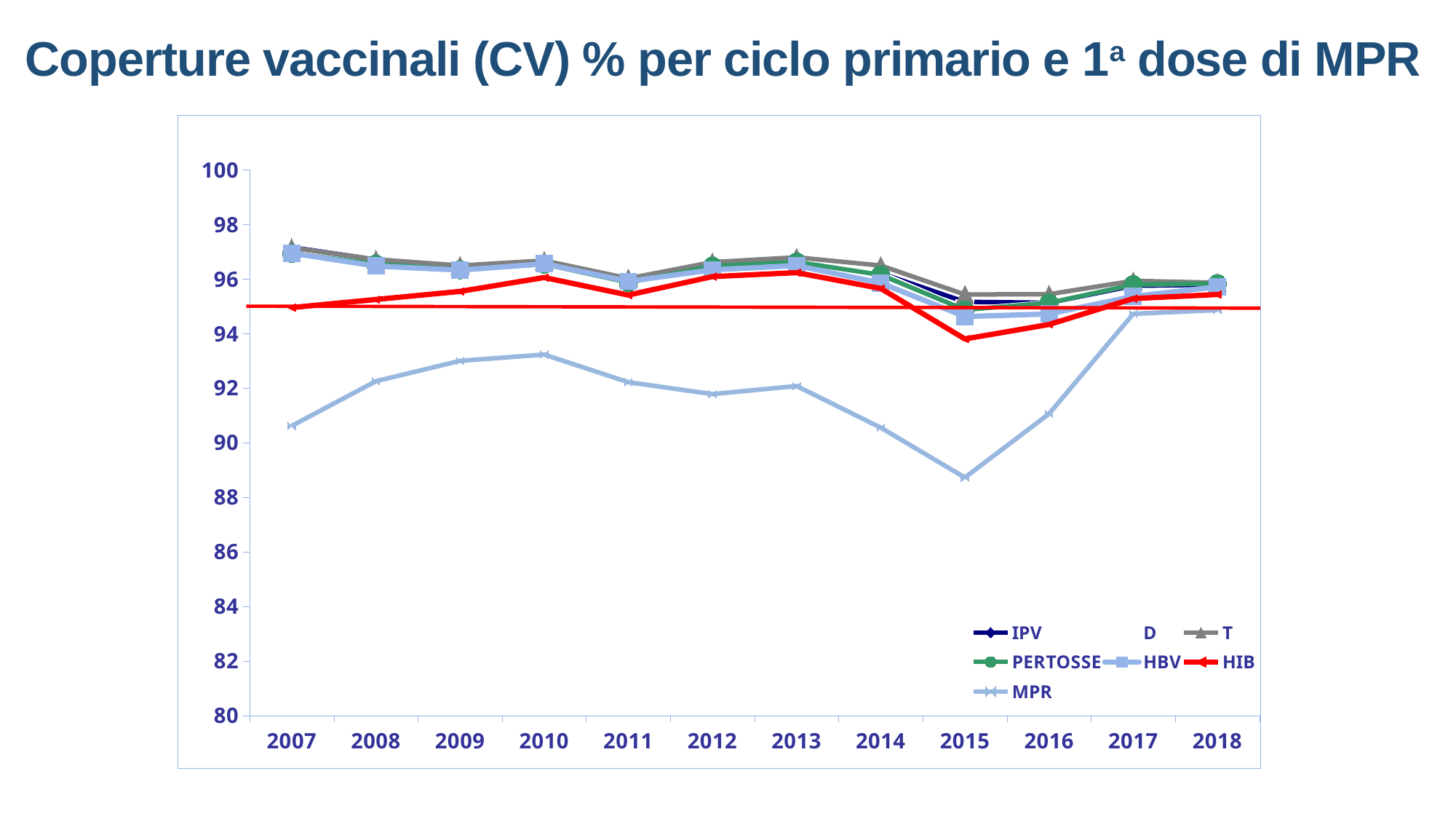
Which series lies lowest on the chart across all years? MPR In which year does the HIB series reach its lowest value? 2015 How many years are shown on the x axis? 12 Is the value for T in 2007 greater or less than 96? greater Which is larger, the MPR value in 2010 or the MPR value in 2015? 2010 Does the MPR series rise or fall between 2015 and 2017? rise Is the value for MPR in 2015 greater or less than 90? less What kind of chart is shown on the slide? line chart Is the value for MPR in 2010 greater or less than 92? greater In which year does the MPR series reach its lowest value? 2015 How many series does the legend list? 7